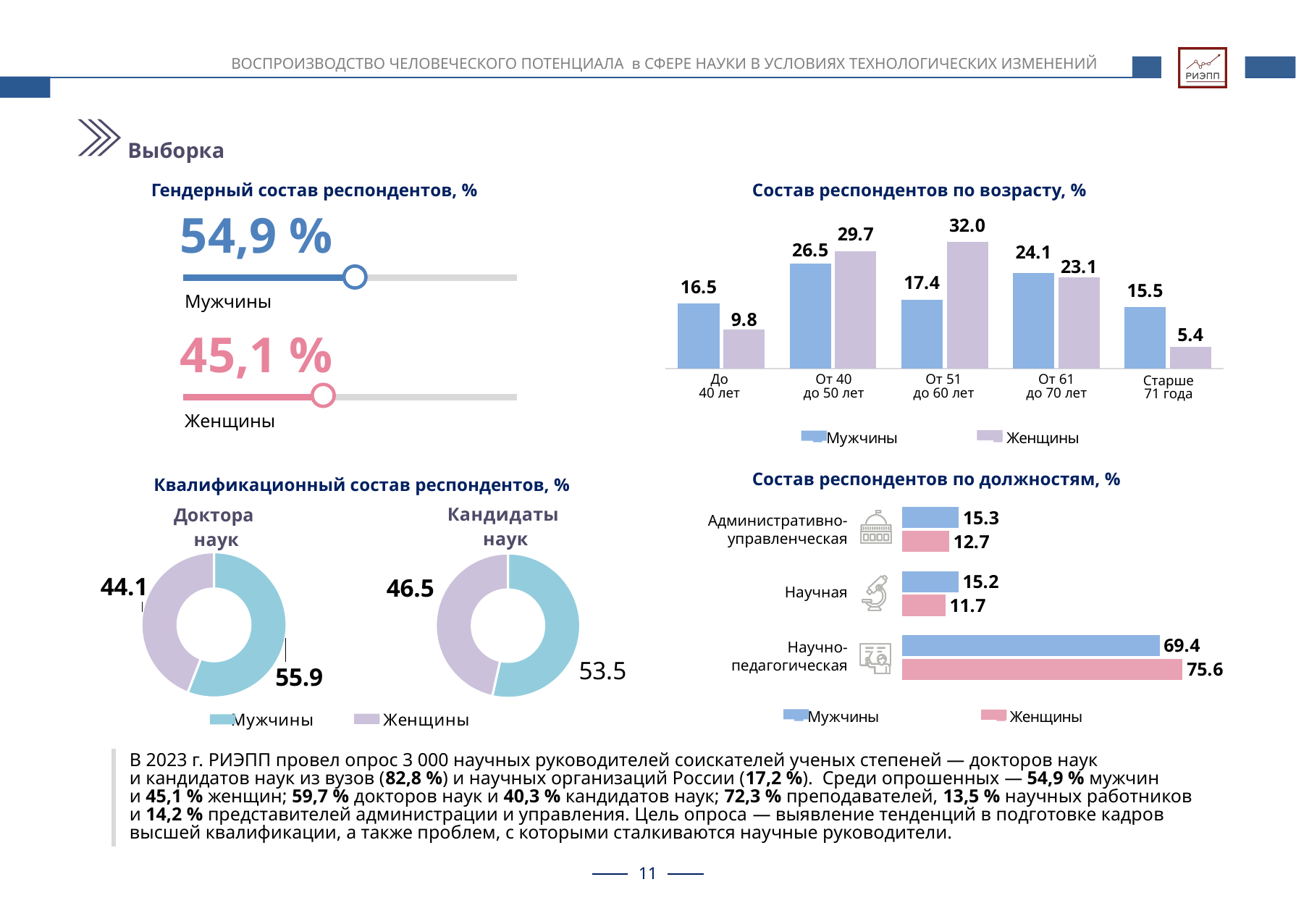
In the chart 'Состав респондентов по возрасту, %', what is the difference between Мужчины and Женщины in the 'Старше 71 года' group? 10.1 In the chart 'Состав респондентов по возрасту, %', which age group has the lowest value for Женщины? Старше 71 года In the chart 'Состав респондентов по возрасту, %', how many series does the legend list? 2 In the chart 'Состав респондентов по должностям, %', which is larger for the 'Научная' category: Мужчины or Женщины? Мужчины In the chart 'Состав респондентов по возрасту, %', which age group has the highest value for Мужчины? От 40 до 50 лет In the chart 'Состав респондентов по возрасту, %', how many age groups are shown on the x axis? 5 In the chart 'Состав респондентов по должностям, %', what is the value for Женщины in the 'Научно-педагогическая' category? 75.6 In the chart 'Состав респондентов по возрасту, %', what is the value for Мужчины in the 'До 40 лет' group? 16.5 In the chart 'Состав респондентов по возрасту, %', what is the value for Женщины in the 'От 51 до 60 лет' group? 32.0 In the 'Доктора наук' donut chart, what share is shown for Мужчины? 55.9 In the 'Кандидаты наук' donut chart, what share is shown for Женщины? 46.5 What kind of chart is 'Состав респондентов по должностям, %'? bar chart